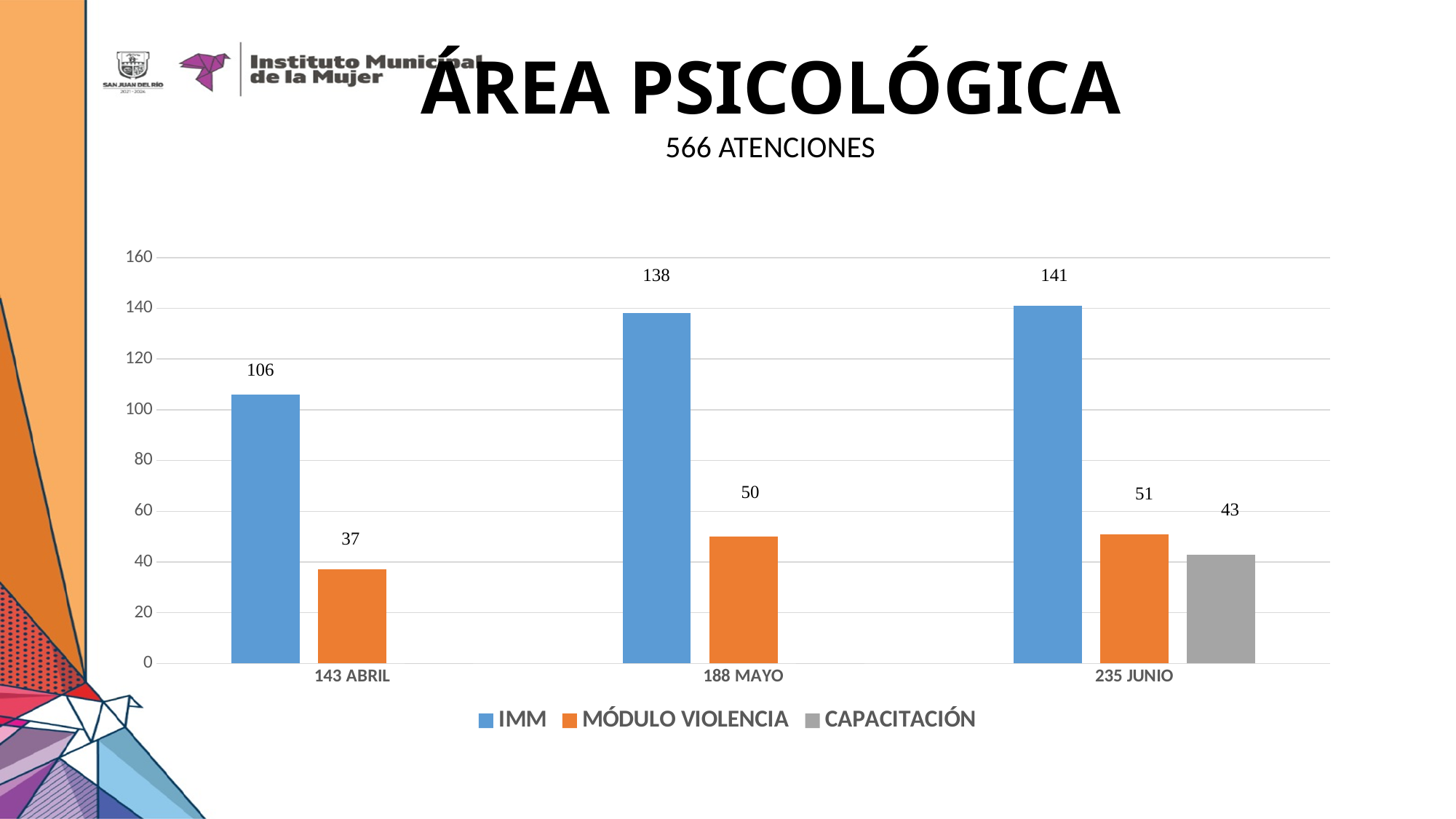
Do the IMM values rise or fall from 143 ABRIL to 235 JUNIO? rise What kind of chart is shown on the slide? bar chart What is the difference between the IMM values for 188 MAYO and 143 ABRIL? 32 What is the IMM value for 235 JUNIO? 141 Which is larger, the IMM value for 143 ABRIL or the MÓDULO VIOLENCIA value for 235 JUNIO? IMM value for 143 ABRIL What is the MÓDULO VIOLENCIA value for 188 MAYO? 50 Which month has the lowest MÓDULO VIOLENCIA value? 143 ABRIL What is the CAPACITACIÓN value for 235 JUNIO? 43 How many series does the legend list? 3 What is the IMM value for 143 ABRIL? 106 Which month has the highest IMM value? 235 JUNIO How many categories are shown on the x axis? 3